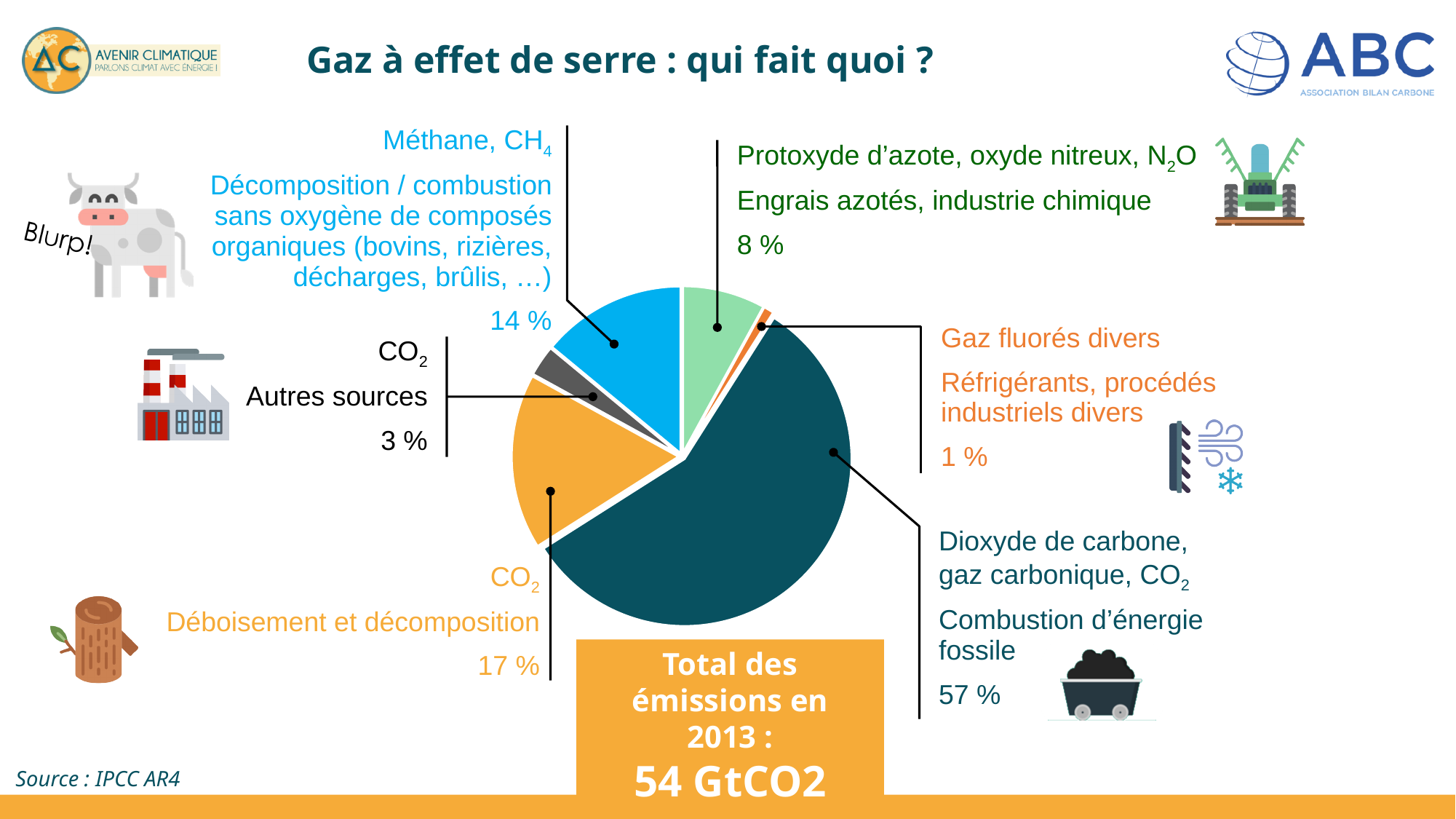
What total emissions figure for 2013 is shown below the pie chart? 54 GtCO2 Which slice of the pie chart is the smallest? Gaz fluorés divers (1 %) What kind of chart is shown on the slide? pie chart Which is larger: the share for CO2 from deforestation and decomposition or the share for methane? CO2 from deforestation and decomposition (17 %) What share of emissions is attributed to nitrous oxide (Protoxyde d'azote, N2O)? 8 % What is the difference in percentage points between the methane share and the nitrous oxide share? 6 % Which slice of the pie chart is the largest? Dioxyde de carbone, combustion d'énergie fossile (57 %) How many slices does the pie chart have? 6 What share of emissions comes from CO2 from deforestation and decomposition (Déboisement et décomposition)? 17 % What share of emissions comes from fluorinated gases (Gaz fluorés divers)? 1 % What share of greenhouse gas emissions comes from CO2 from combustion of fossil energy (Combustion d'énergie fossile)? 57 % What share of emissions is attributed to methane (Méthane, CH4)? 14 %